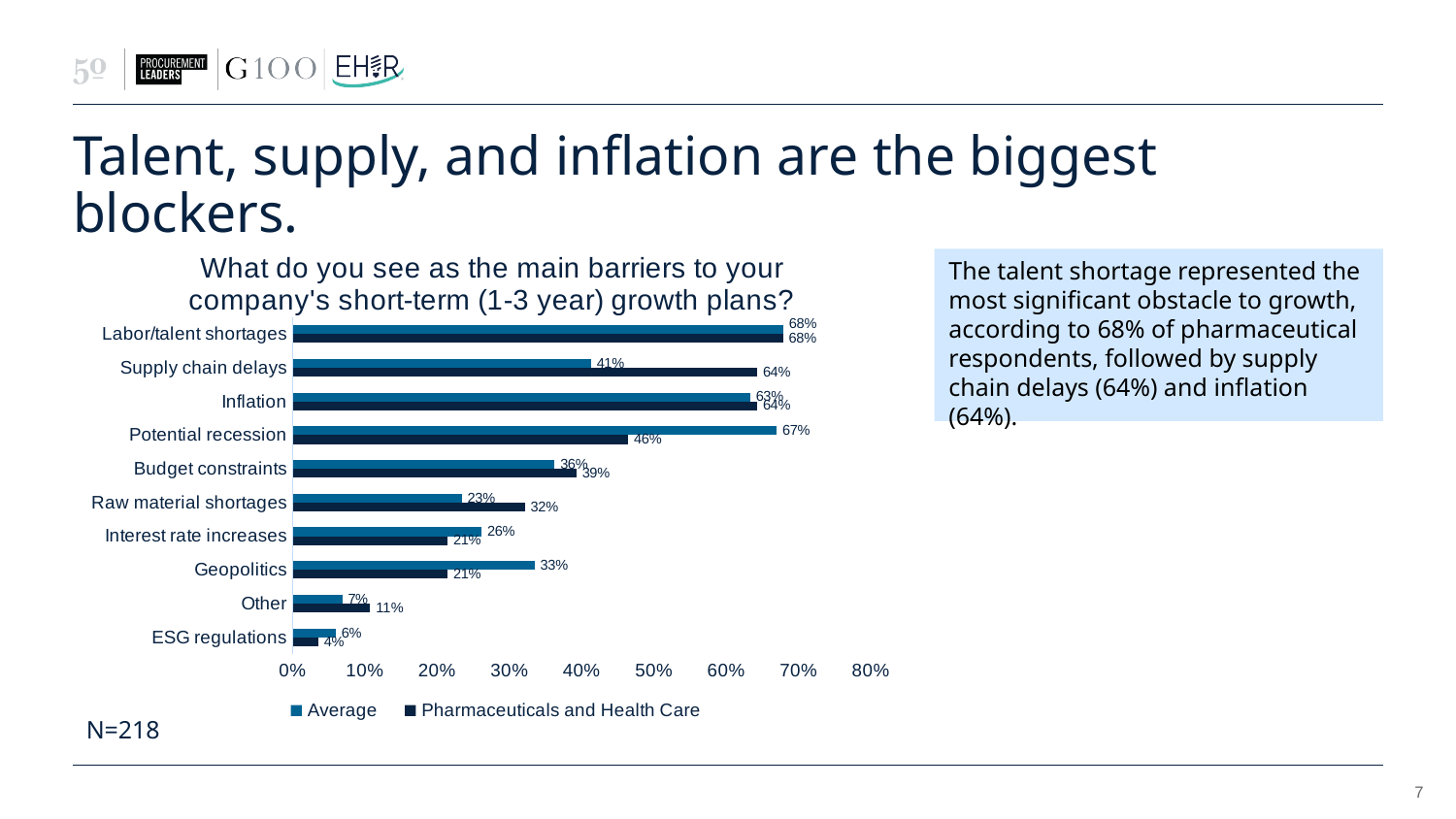
What kind of chart is shown on the slide? Bar chart Which category has the lowest Pharmaceuticals and Health Care value? ESG regulations For Geopolitics, which series has the larger value, Average or Pharmaceuticals and Health Care? Average For Geopolitics, what is the difference between the Average value and the Pharmaceuticals and Health Care value? 12 percentage points Is the Pharmaceuticals and Health Care value for Potential recession greater or less than 50%? less What is the Average value for Potential recession? 67% What is the value for Pharmaceuticals and Health Care for Supply chain delays? 64% For Supply chain delays, how much higher is the Pharmaceuticals and Health Care value than the Average value? 23 percentage points How many series does the legend list? 2 Which category has the lowest Average value? ESG regulations What is the Pharmaceuticals and Health Care value for Other? 11% How many barrier categories are shown in the chart? 10